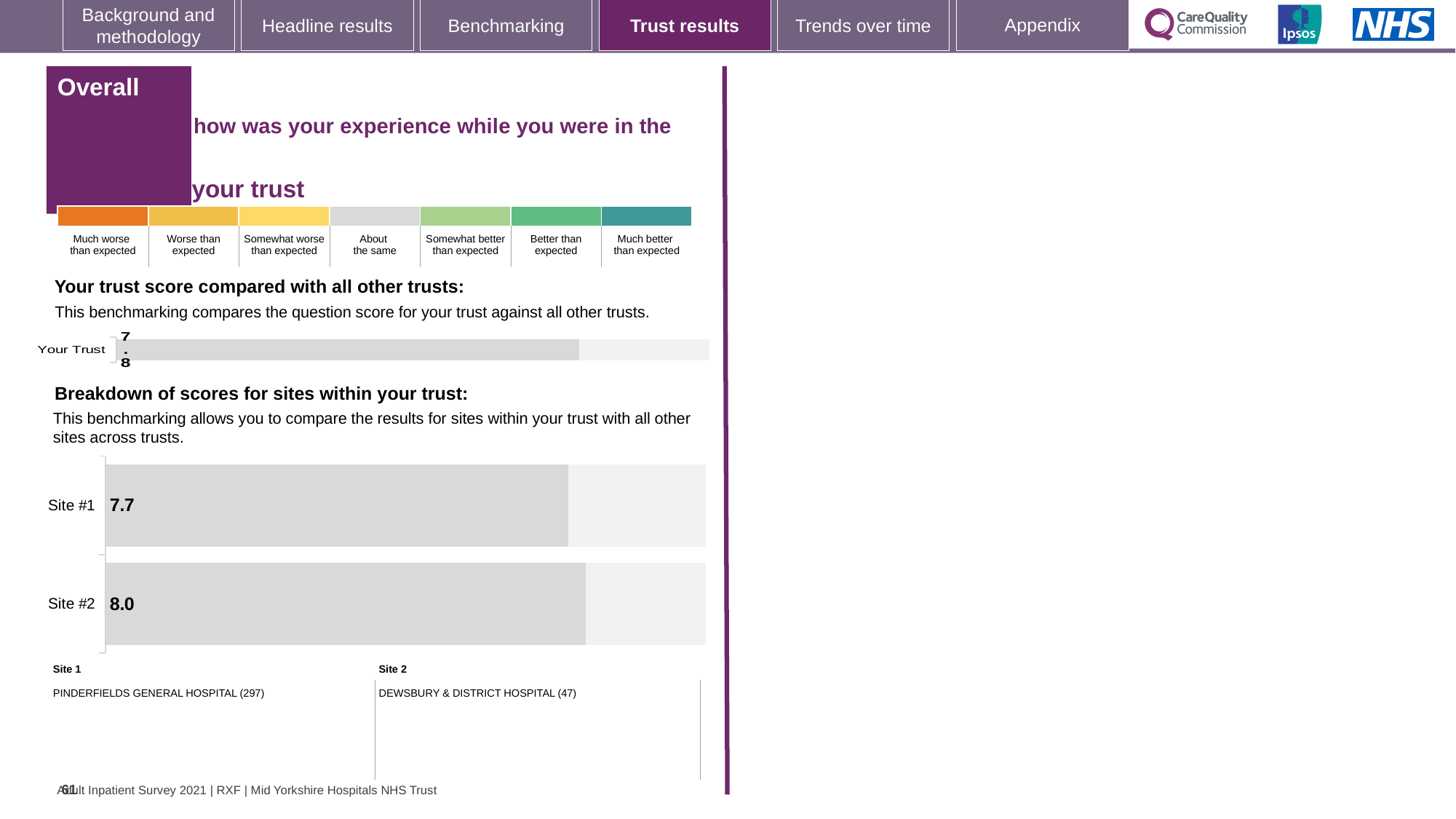
In the 'Breakdown of scores for sites within your trust' chart, which site has the lower score? Site #1 How many sites are plotted in the 'Breakdown of scores for sites within your trust' chart? 2 In the 'Breakdown of scores for sites within your trust' chart, which site has the higher score? Site #2 Which hospital is listed as Site 1 below the site breakdown chart? PINDERFIELDS GENERAL HOSPITAL (297) In the 'Breakdown of scores for sites within your trust' chart, what is the score for Site #2? 8.0 In the 'Breakdown of scores for sites within your trust' chart, what is the score for Site #1? 7.7 How many bars are shown in the 'Your trust score compared with all other trusts' chart? 1 In the 'Breakdown of scores for sites within your trust' chart, what is the difference between the scores for Site #2 and Site #1? 0.3 In the 'Your trust score compared with all other trusts' chart, what is the score shown for Your Trust? 7.8 What kind of chart is used in the 'Breakdown of scores for sites within your trust' section? bar chart In the 'Breakdown of scores for sites within your trust' chart, is the score for Site #1 larger or smaller than the score for Site #2? smaller Which hospital is listed as Site 2 below the site breakdown chart? DEWSBURY & DISTRICT HOSPITAL (47)